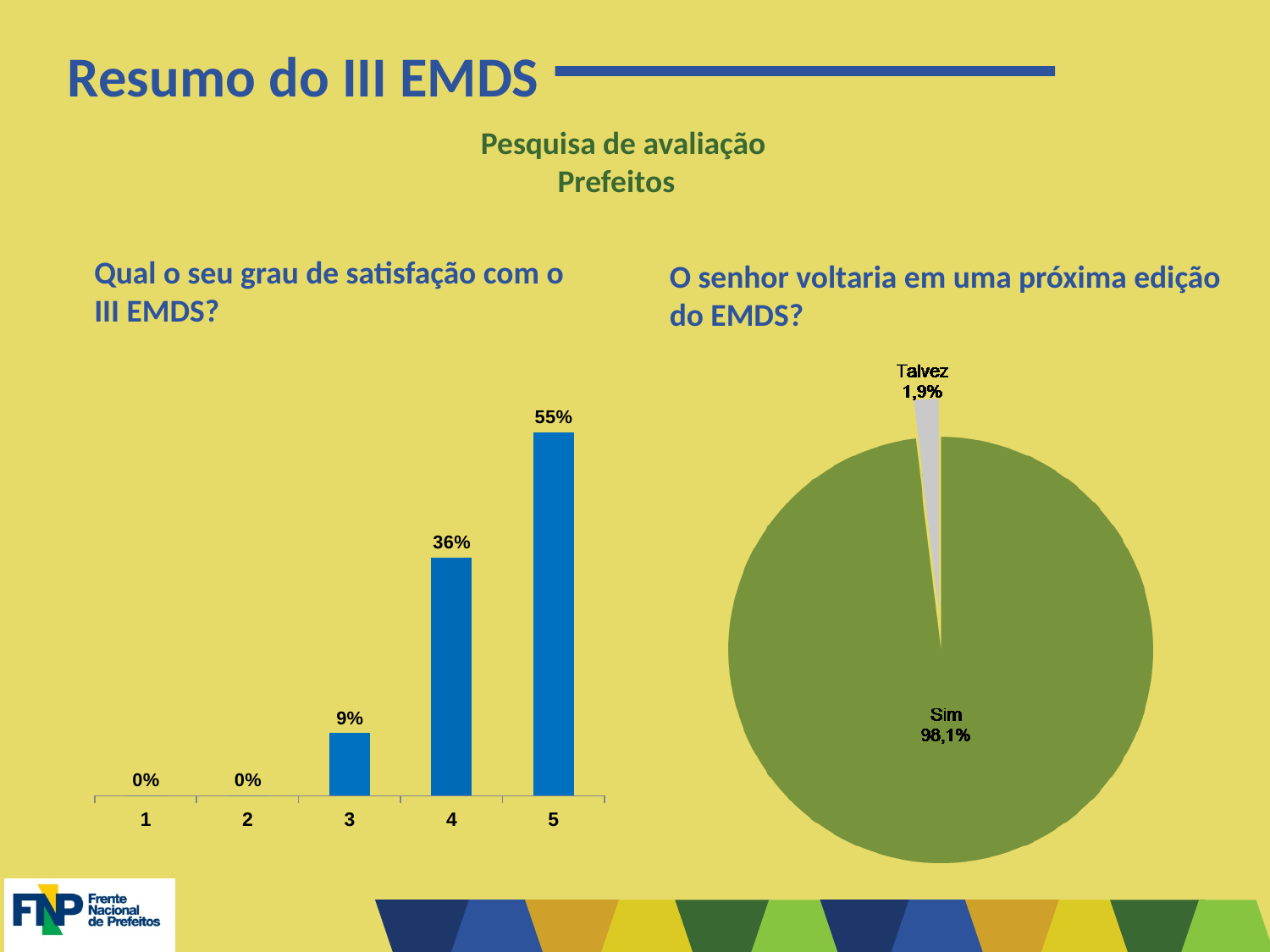
In the bar chart on the left (satisfaction with III EMDS), which category has the highest value? 5 In the pie chart on the right (would return to a next EMDS), what share does 'Talvez' have? 1,9% In the bar chart on the left (satisfaction with III EMDS), which is larger, the value for category 3 or category 4? 4 In the bar chart on the left (satisfaction with III EMDS), what is the difference between the values for categories 5 and 4? 19% In the bar chart on the left (satisfaction with III EMDS), do the values rise or fall from category 1 to category 5? rise What kind of chart is the chart on the right (would return to a next EMDS)? pie chart In the bar chart on the left (satisfaction with III EMDS), what is the value for category 4? 36% In the bar chart on the left (satisfaction with III EMDS), what is the value for category 5? 55% What kind of chart is the chart on the left (satisfaction with III EMDS)? bar chart In the bar chart on the left (satisfaction with III EMDS), how many categories are shown on the x axis? 5 In the pie chart on the right (would return to a next EMDS), what share does 'Sim' have? 98,1% In the bar chart on the left (satisfaction with III EMDS), what is the value for category 3? 9%